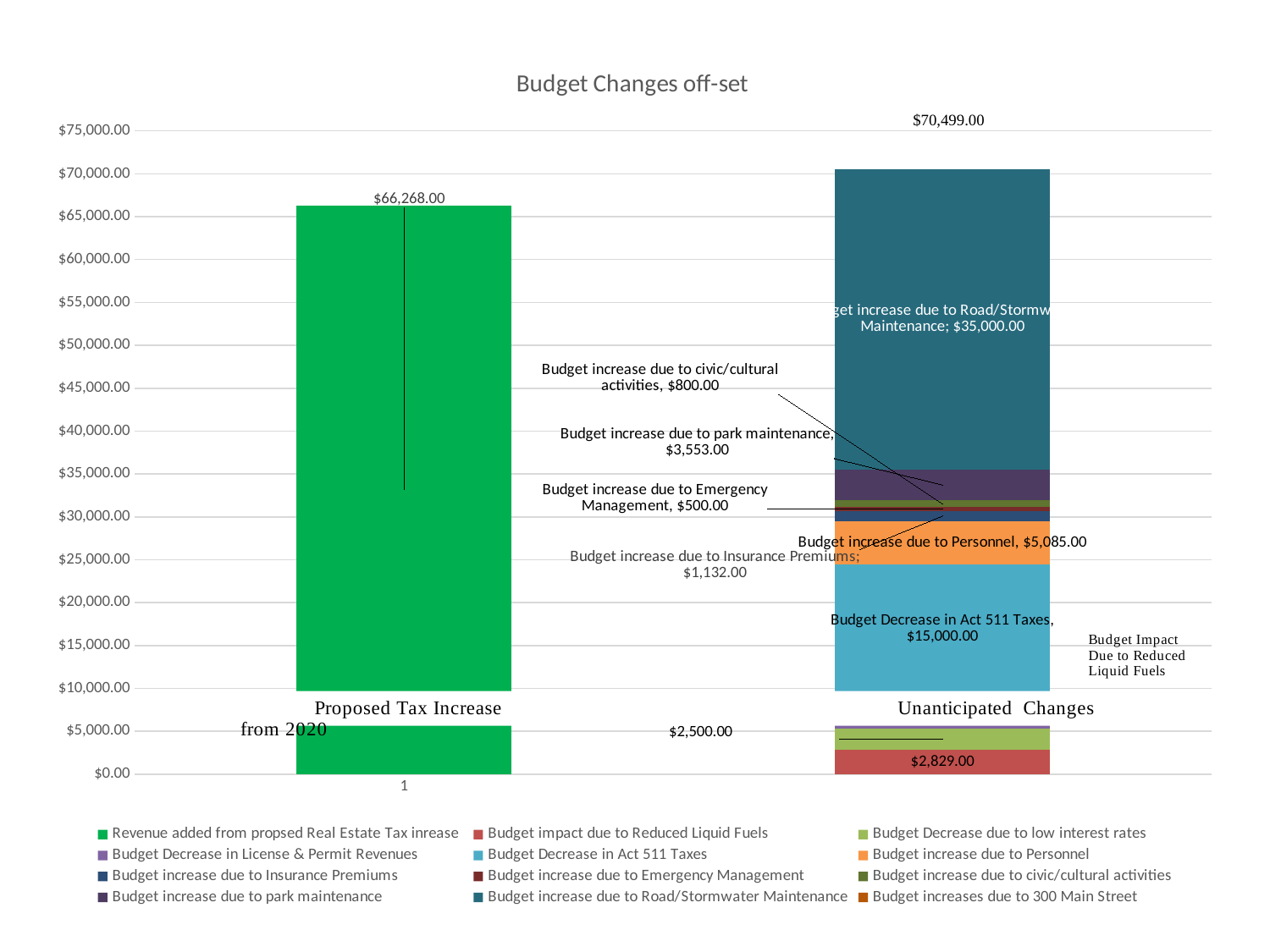
What is the total of the Unanticipated Changes stacked bar? $70,499.00 Is the value of the Proposed Tax Increase from 2020 bar greater or less than $65,000.00? greater What is the value of the Budget increase due to Personnel segment? $5,085.00 Which segment of the Unanticipated Changes bar is the largest? Budget increase due to Road/Stormwater Maintenance What is the value of the Budget increase due to Road/Stormwater Maintenance segment? $35,000.00 What is the value of the Budget Decrease in Act 511 Taxes segment? $15,000.00 What is the value of the Budget increase due to park maintenance segment? $3,553.00 How many series does the legend list? 12 What kind of chart is shown on the slide? Stacked bar chart What is the difference between the Unanticipated Changes total and the Proposed Tax Increase from 2020 value? $4,231.00 What is the value of the Proposed Tax Increase from 2020 bar? $66,268.00 What is the title of the chart? Budget Changes off-set